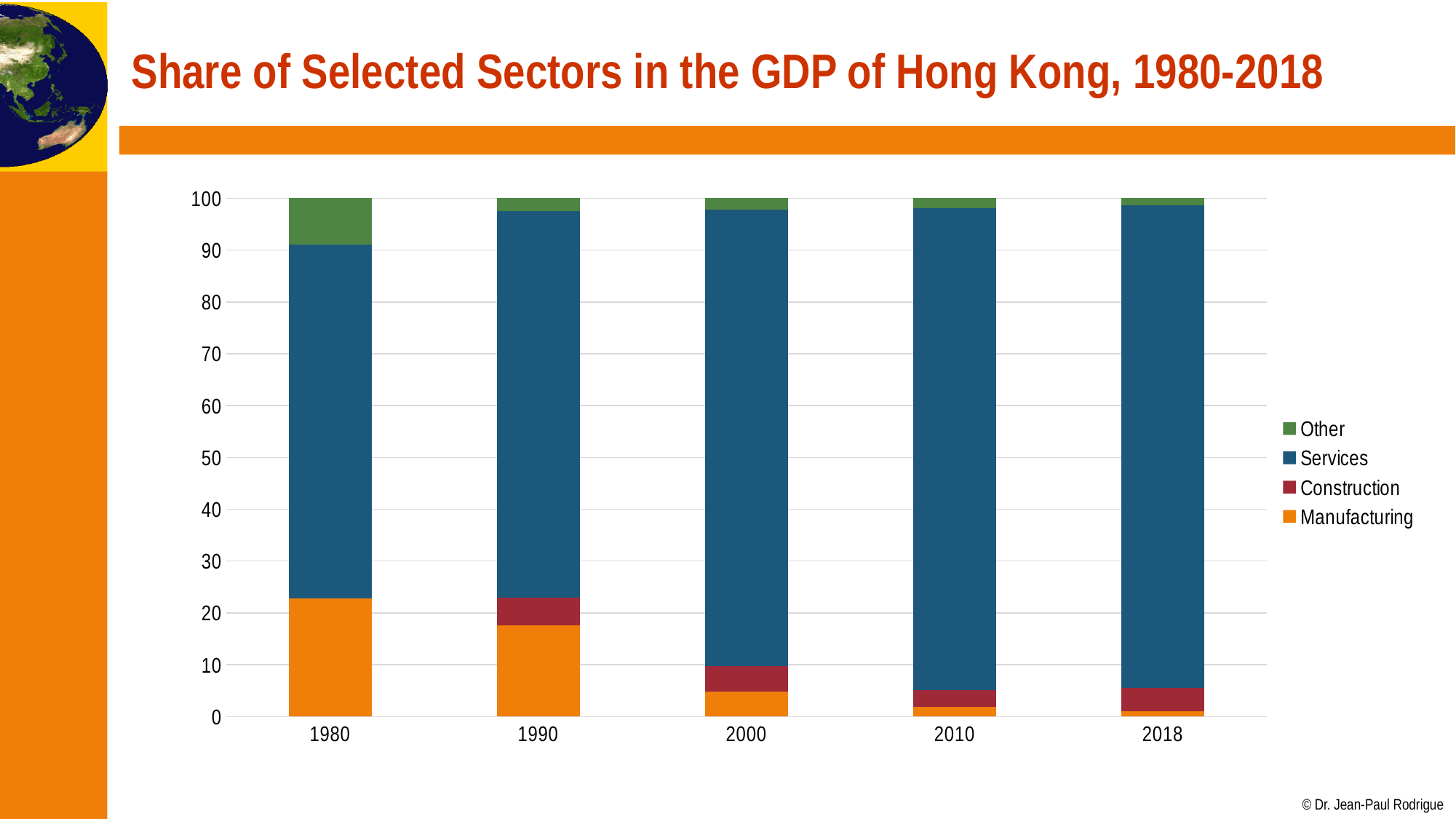
How many series does the legend list? 4 Is the Manufacturing share in 2000 greater or less than 10? less Which is larger, the Manufacturing share in 1990 or the Manufacturing share in 2010? 1990 Does the Manufacturing share rise or fall from 1980 to 2018? Fall What is the total height of the stacked bar for 1980? 100 Which series are listed in the legend? Other, Services, Construction, Manufacturing Is the Manufacturing share in 1980 greater or less than 20? greater What is the title of the chart? Share of Selected Sectors in the GDP of Hong Kong, 1980-2018 In which year is the Other share the highest? 1980 In which year is the Manufacturing share the highest? 1980 How many years are shown along the x axis of the chart? 5 What kind of chart is shown on the slide? Stacked bar chart